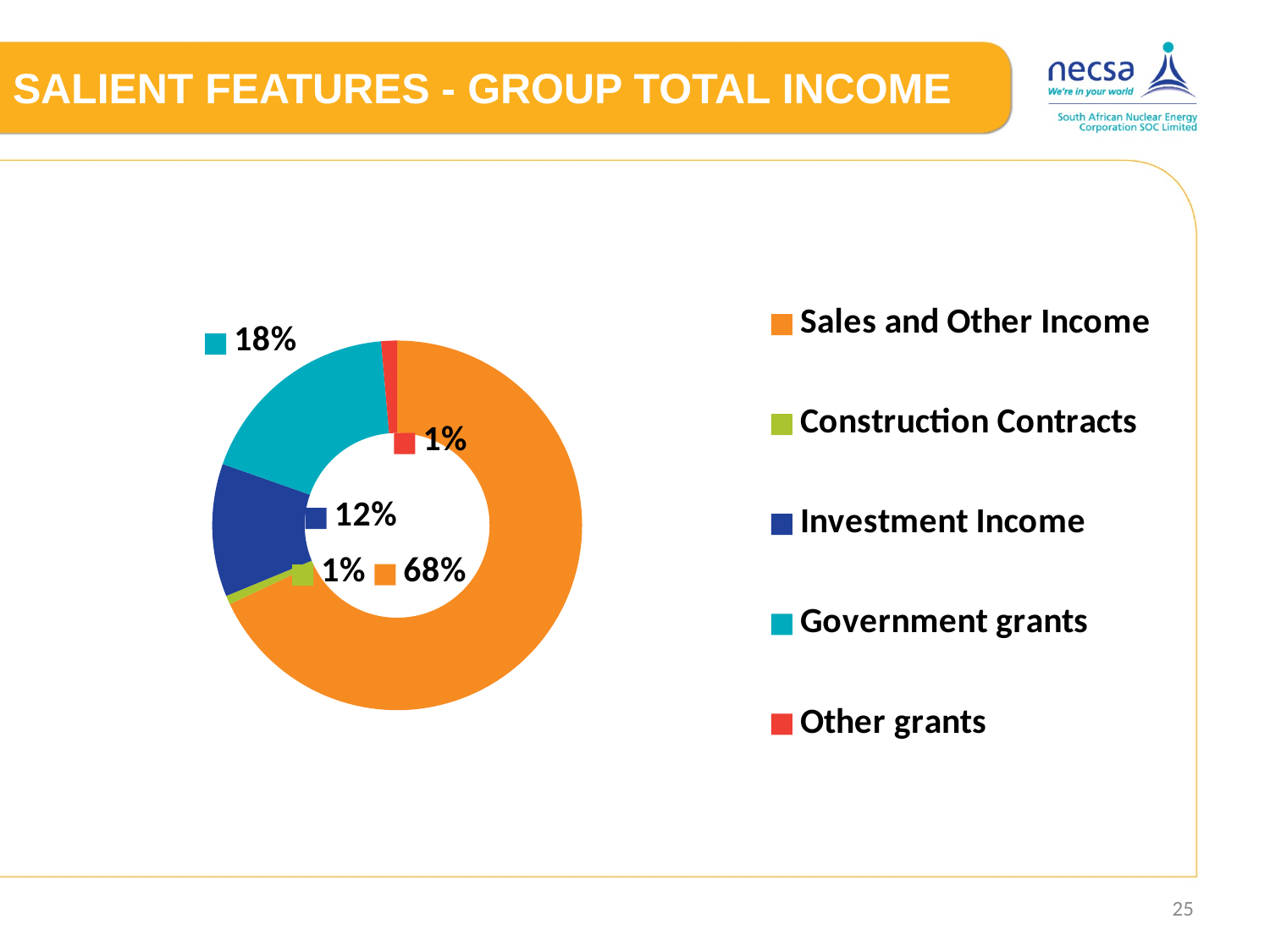
Which category has the largest share of group total income? Sales and Other Income What is the difference in percentage points between the Government grants share and the Investment Income share? 6 What is the difference in percentage points between the Sales and Other Income share and the Government grants share? 50 How many categories does the chart show? 5 What share of group total income comes from Government grants? 18% What share of group total income comes from Investment Income? 12% What share of group total income comes from Other grants? 1% What kind of chart is shown on the slide? Pie chart (doughnut) What colour represents Investment Income in the chart? Dark blue What share of group total income comes from Sales and Other Income? 68% Which is larger, the share for Government grants or the share for Investment Income? Government grants What share of group total income comes from Construction Contracts? 1%